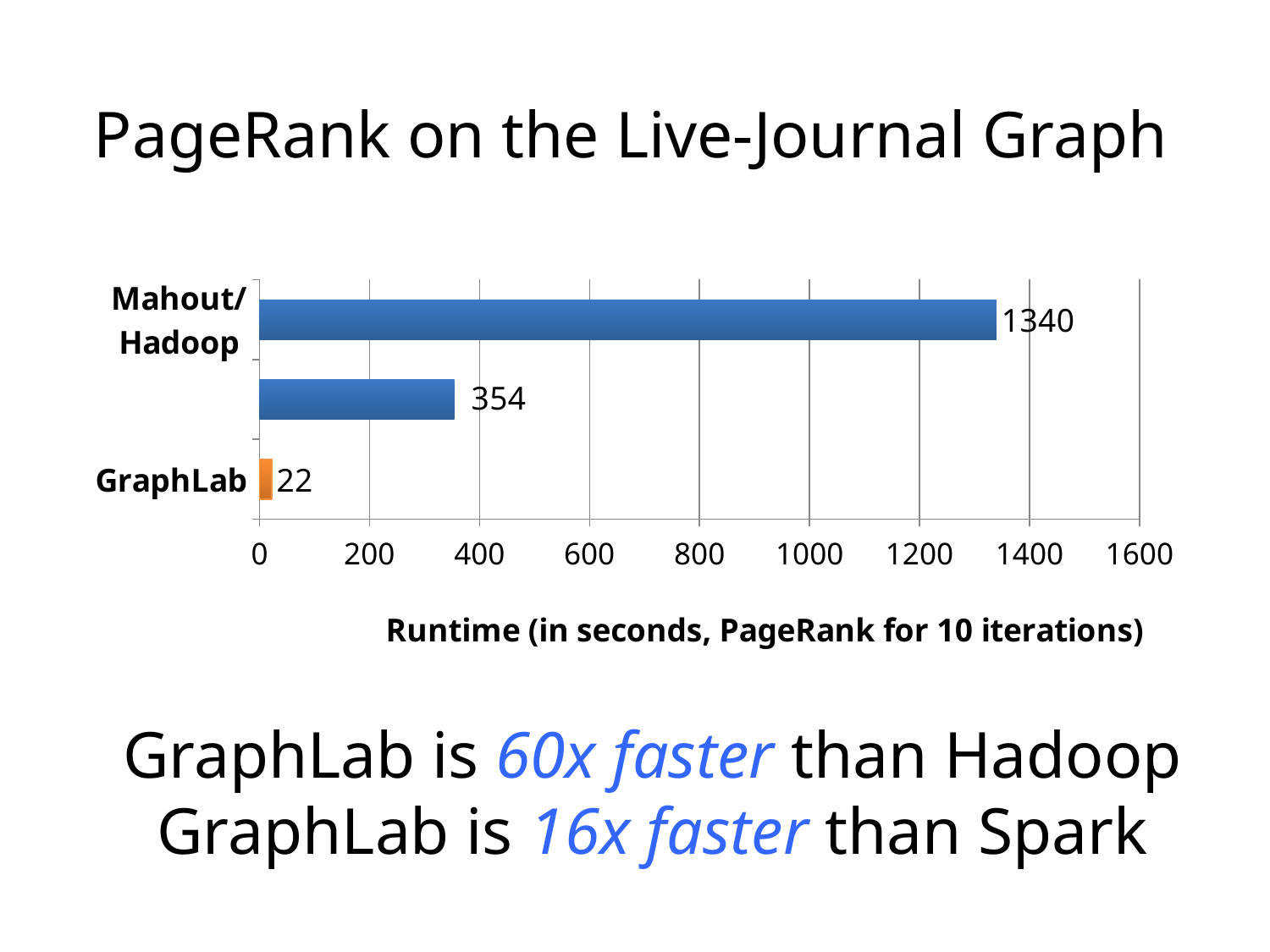
Is the value for Mahout/Hadoop greater or less than 1200? greater What is the runtime value shown for Mahout/Hadoop? 1340 What colour is the GraphLab bar? orange What is the runtime value shown for GraphLab? 22 Which labelled category has the lowest runtime? GraphLab What is the title of the horizontal axis of the chart? Runtime (in seconds, PageRank for 10 iterations) What is the difference in runtime between Mahout/Hadoop and GraphLab? 1318 What value is labelled on the middle (unlabelled) bar of the chart? 354 Which labelled category has the highest runtime? Mahout/Hadoop Which has a larger runtime, Mahout/Hadoop or GraphLab? Mahout/Hadoop How many bars are plotted in the chart? 3 What kind of chart is shown on the slide? bar chart